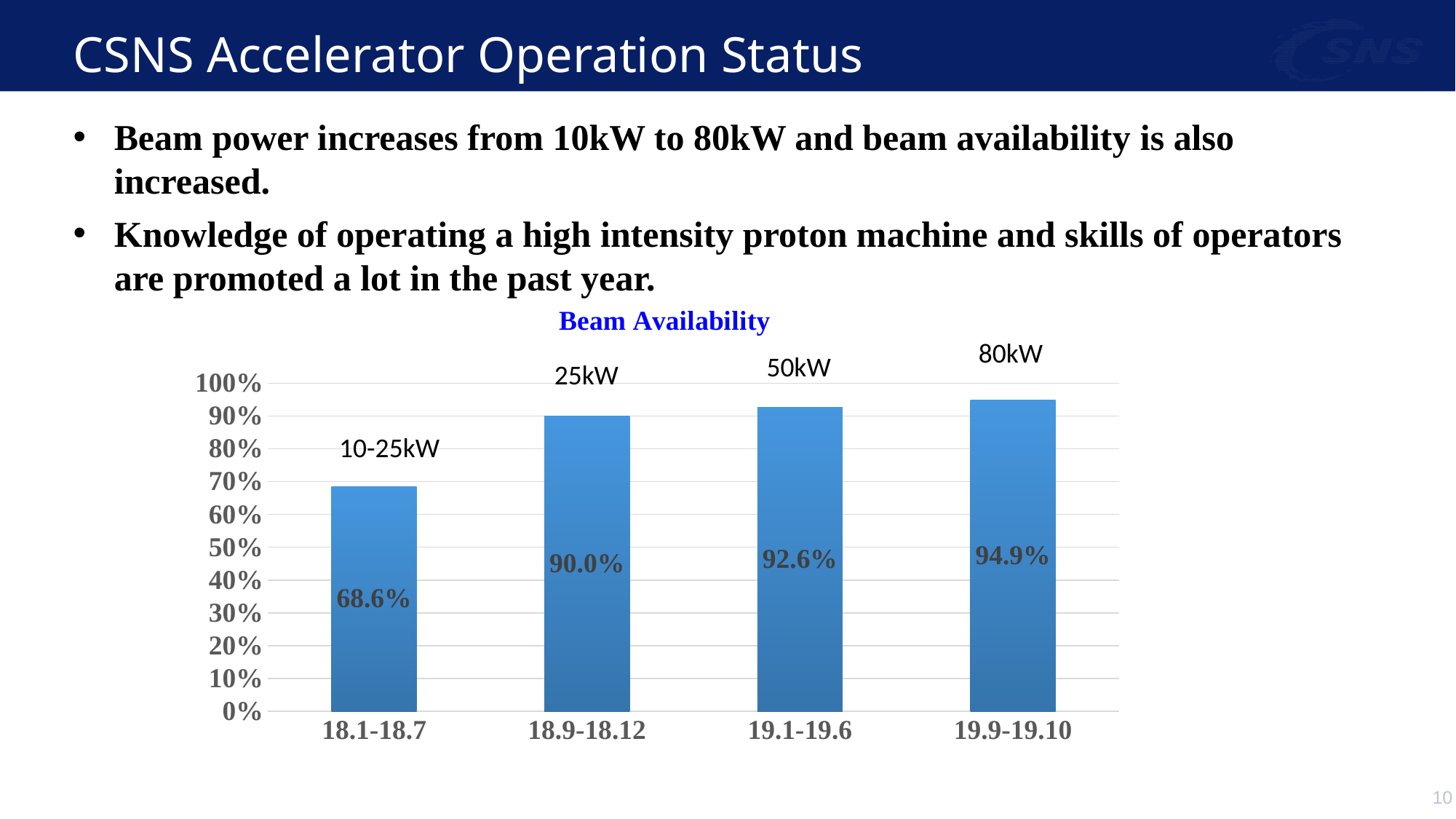
What is the beam availability for the period 18.9-18.12? 90.0% How many periods are shown in the Beam Availability chart? 4 Which period has a higher beam availability, 18.9-18.12 or 19.1-19.6? 19.1-19.6 Which period has the lowest beam availability? 18.1-18.7 What is the beam availability for the period 18.1-18.7? 68.6% What kind of chart is used to show Beam Availability? Bar chart Which period has the highest beam availability? 19.9-19.10 Does beam availability rise or fall across the periods from 18.1-18.7 to 19.9-19.10? Rise What is the difference in beam availability between 19.9-19.10 and 18.1-18.7? 26.3% What is the beam availability for the period 19.1-19.6? 92.6% What beam power label is shown above the bar for 19.1-19.6? 50kW What is the beam availability for the period 19.9-19.10? 94.9%